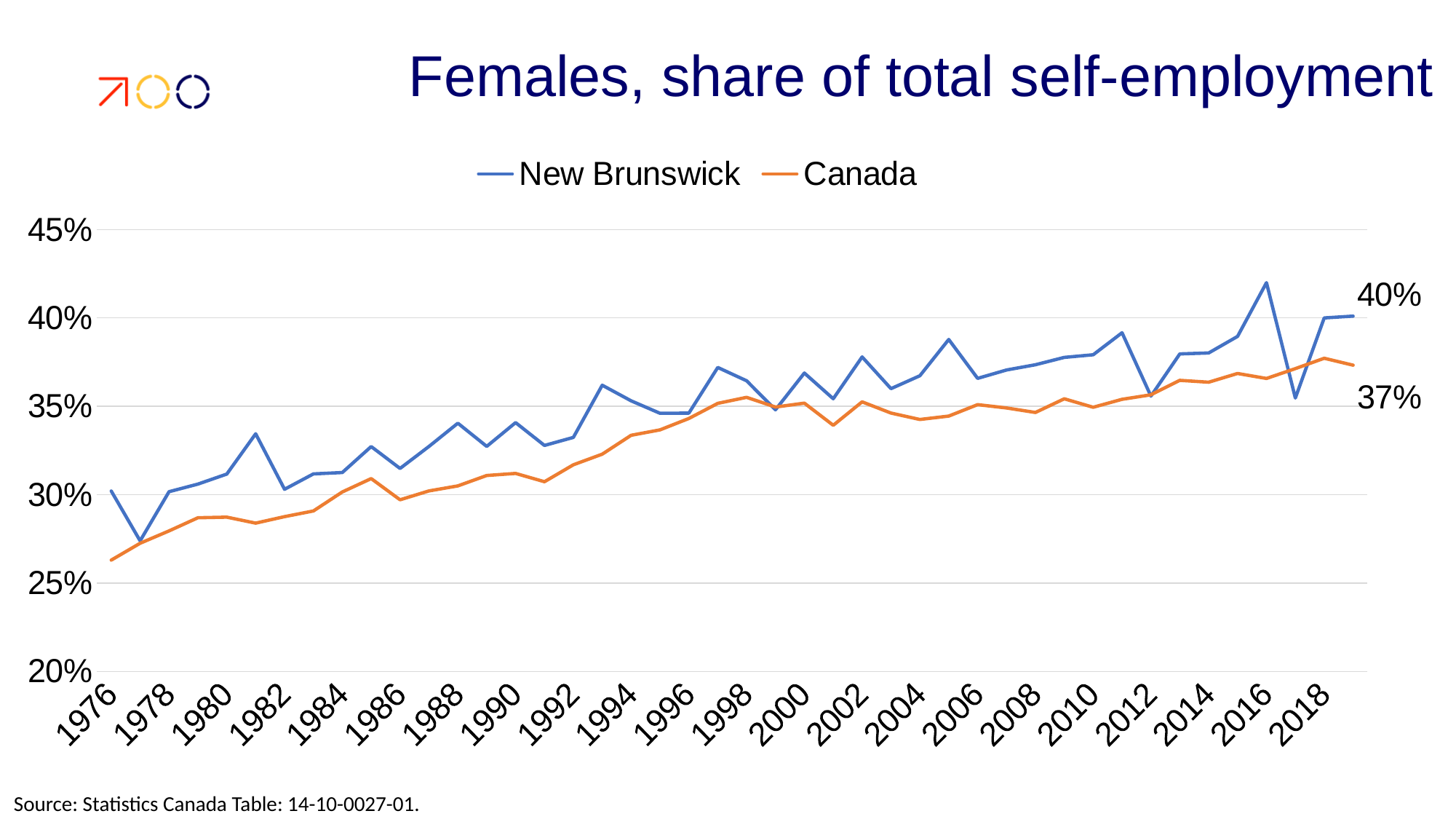
Is the New Brunswick value in 2016 greater or less than 40%? greater At the end of the series, which is larger: the New Brunswick value or the Canada value? New Brunswick What is the title of the chart? Females, share of total self-employment Do the values for Canada generally rise or fall from 1976 to the end of the series? rise Is the Canada value in 1976 greater or less than 30%? less What are the two series named in the legend? New Brunswick and Canada What kind of chart is shown on the slide? line chart How many series does the legend list? 2 What is the difference between the labelled end values for New Brunswick and Canada? 3 percentage points Is the New Brunswick value in 1976 greater or less than 35%? less What value is labelled at the end of the Canada line? 37% What value is labelled at the end of the New Brunswick line? 40%